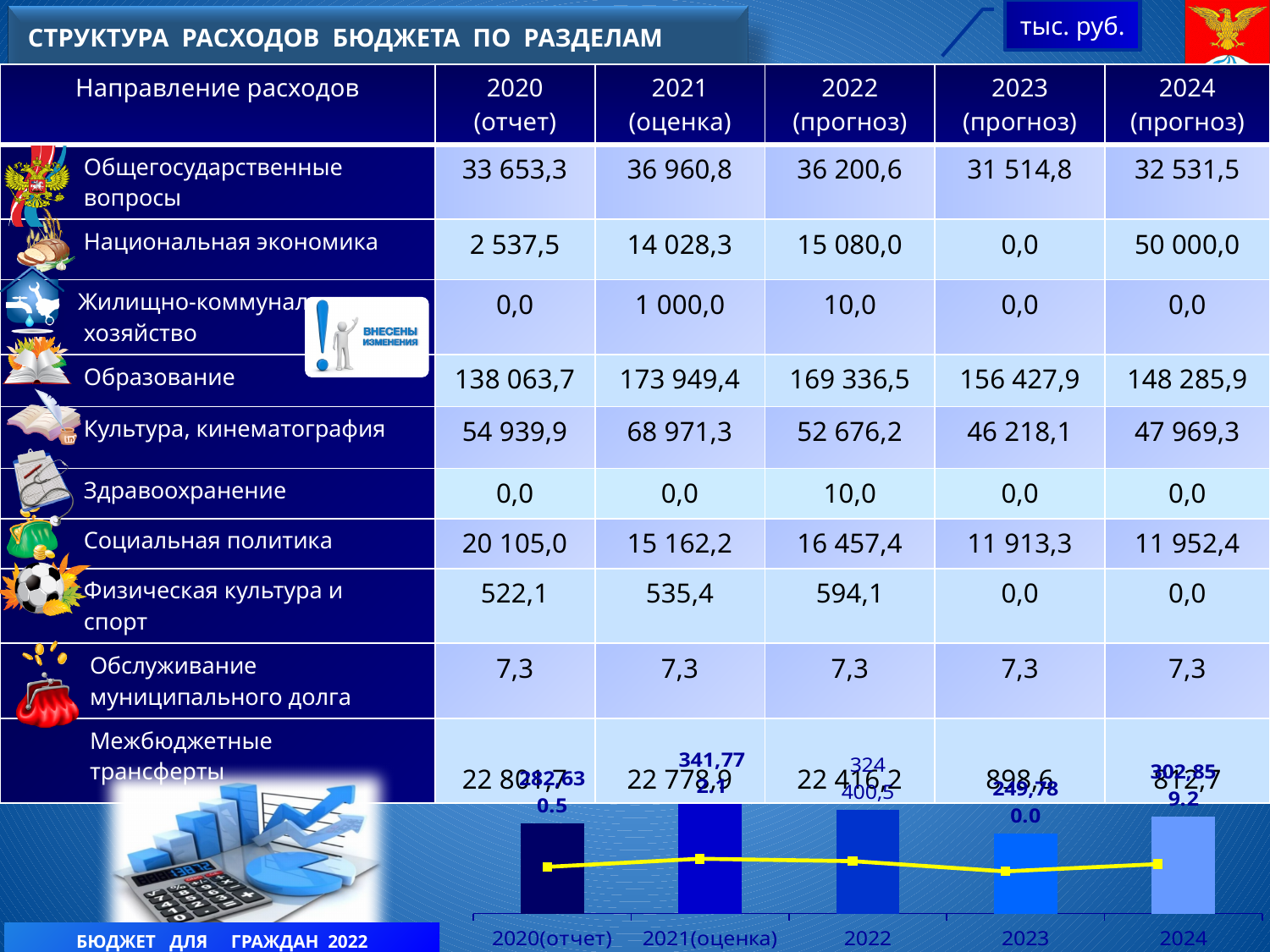
How many categories are shown on the x axis of the chart at the bottom of the slide? 5 What kind of chart is shown at the bottom of the slide? bar chart with a line In the chart at the bottom of the slide, which category has the lowest bar? 2023 In the chart at the bottom of the slide, which bar is larger: 2021(оценка) or 2023? 2021(оценка) What is the first category label on the x axis of the chart at the bottom of the slide? 2020(отчет)